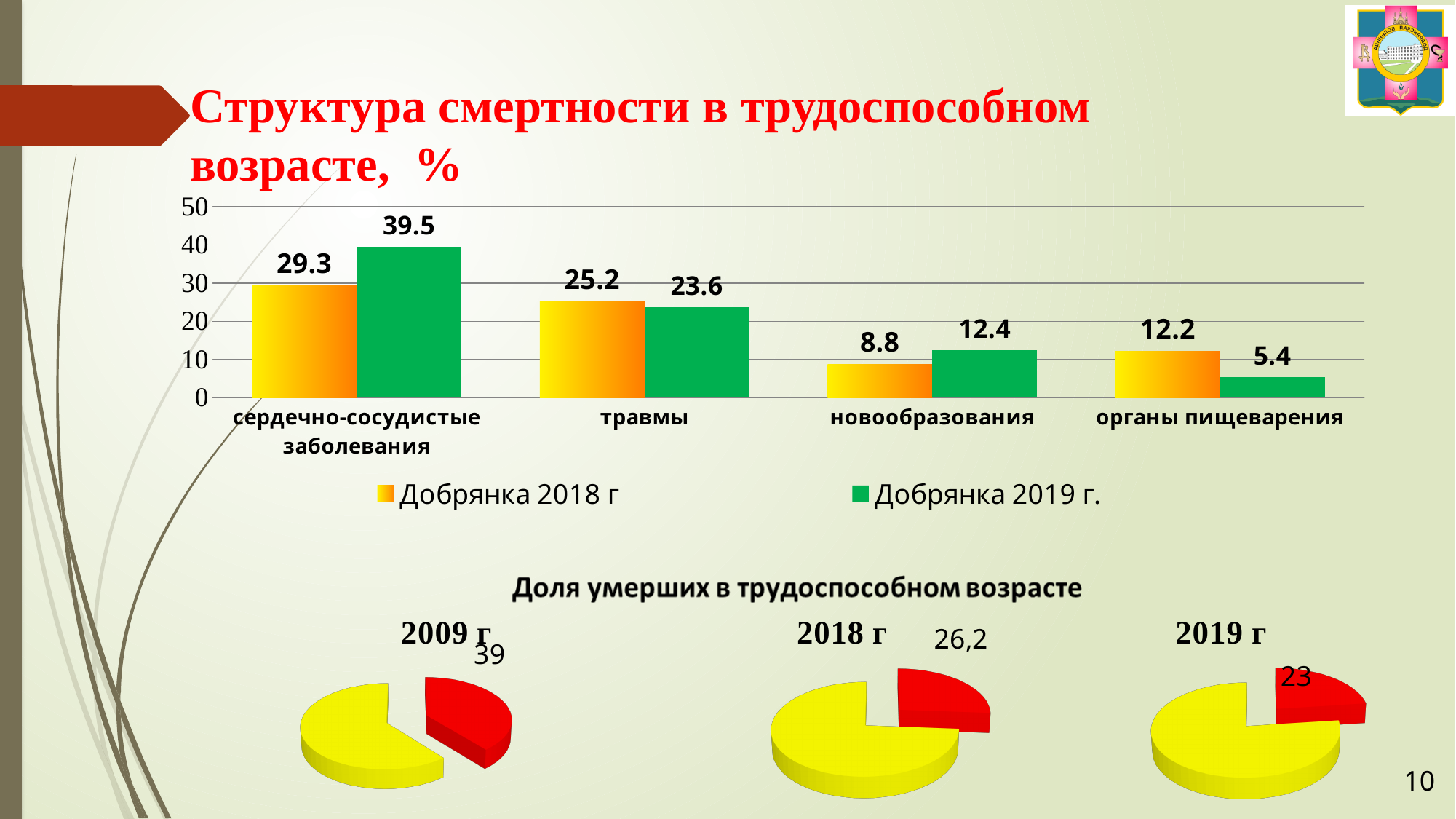
In the bar chart 'Структура смертности в трудоспособном возрасте, %', which category has the highest value in the 'Добрянка 2018 г' series? сердечно-сосудистые заболевания In the bar chart 'Структура смертности в трудоспособном возрасте, %', what is the value for 'травмы' in the 'Добрянка 2018 г' series? 25.2 In the bar chart 'Структура смертности в трудоспособном возрасте, %', which series has the larger value for 'новообразования'? Добрянка 2019 г. In the bar chart 'Структура смертности в трудоспособном возрасте, %', what is the value for 'сердечно-сосудистые заболевания' in the 'Добрянка 2019 г.' series? 39.5 In the pie charts 'Доля умерших в трудоспособном возрасте', which year has the largest red slice? 2009 г In the pie charts 'Доля умерших в трудоспособном возрасте', what is the value of the red slice for 2018 г? 26,2 In the bar chart 'Структура смертности в трудоспособном возрасте, %', what is the value for 'органы пищеварения' in the 'Добрянка 2019 г.' series? 5.4 In the bar chart 'Структура смертности в трудоспособном возрасте, %', how many categories are shown on the x axis? 4 In the bar chart 'Структура смертности в трудоспособном возрасте, %', what is the difference between the 'Добрянка 2019 г.' and 'Добрянка 2018 г' values for 'сердечно-сосудистые заболевания'? 10.2 In the bar chart 'Структура смертности в трудоспособном возрасте, %', which category has the lowest value in the 'Добрянка 2019 г.' series? органы пищеварения In the bar chart 'Структура смертности в трудоспособном возрасте, %', how many series does the legend list? 2 What kind of chart is the top chart 'Структура смертности в трудоспособном возрасте, %'? bar chart